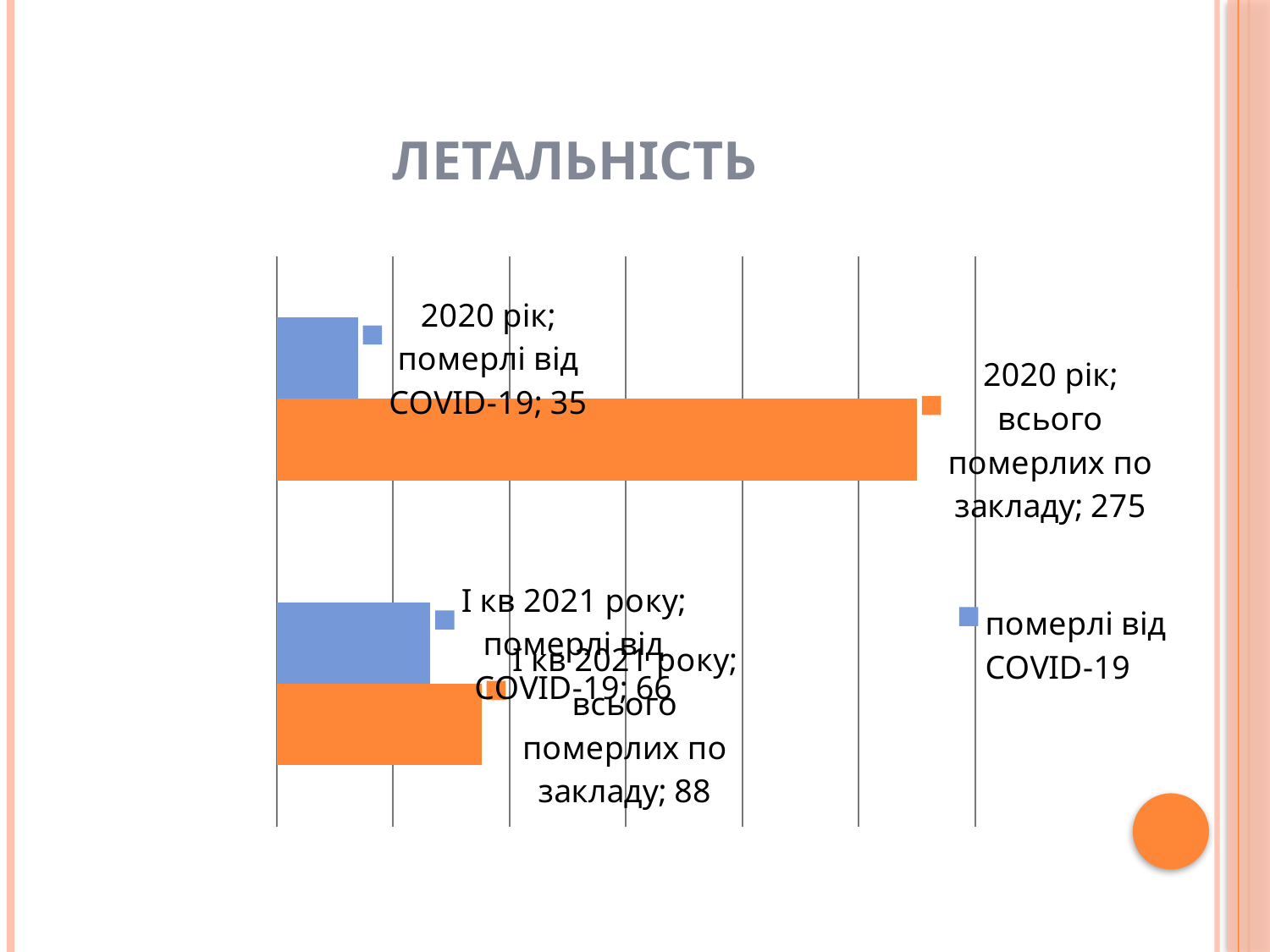
What type of chart is shown on the slide? bar chart Which is larger: COVID-19 deaths in 2020 or COVID-19 deaths in I кв 2021 року? I кв 2021 року What is the title of the chart? ЛЕТАЛЬНІСТЬ What is the total number of deaths in the institution in 2020 (2020 рік, всього померлих по закладу)? 275 How many categories (time periods) are shown on the chart? 2 Which bar has the lowest value on the chart? 2020 рік; померлі від COVID-19 What is the difference between total deaths and COVID-19 deaths in 2020? 240 What is the difference between total deaths and COVID-19 deaths in I кв 2021 року? 22 Which bar has the highest value on the chart? 2020 рік; всього померлих по закладу How many people died from COVID-19 in I кв 2021 року? 66 How many people died from COVID-19 in 2020 (2020 рік, померлі від COVID-19)? 35 What is the total number of deaths in the institution in I кв 2021 року (всього померлих по закладу)? 88